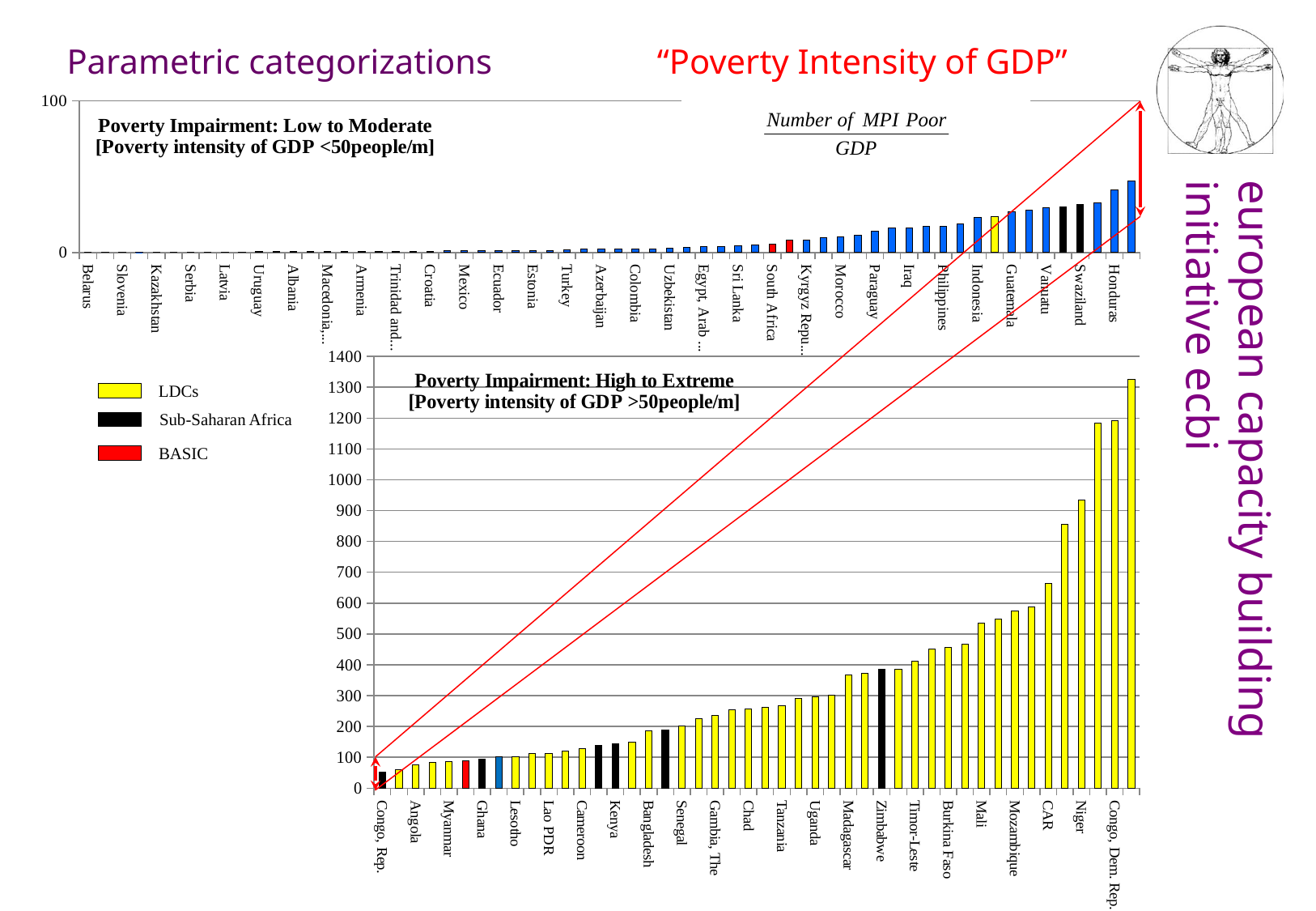
In the "Poverty Impairment: Low to Moderate" chart, is the value for Honduras greater or less than 100? less In the "Poverty Impairment: High to Extreme" chart, do the values rise or fall from left to right along the x axis? rise In the "Poverty Impairment: High to Extreme" chart, is the value for Zimbabwe greater or less than 500? less How many entries does the legend on the slide list? 3 In the "Poverty Impairment: High to Extreme" chart, which is larger, the value for Niger or the value for Mali? Niger In the "Poverty Impairment: High to Extreme" chart, is the value for Angola greater or less than 100? less In the "Poverty Impairment: High to Extreme" chart, which country has the lowest value? Congo, Rep. What kind of chart is the "Poverty Impairment: High to Extreme" chart at the bottom of the slide? bar chart